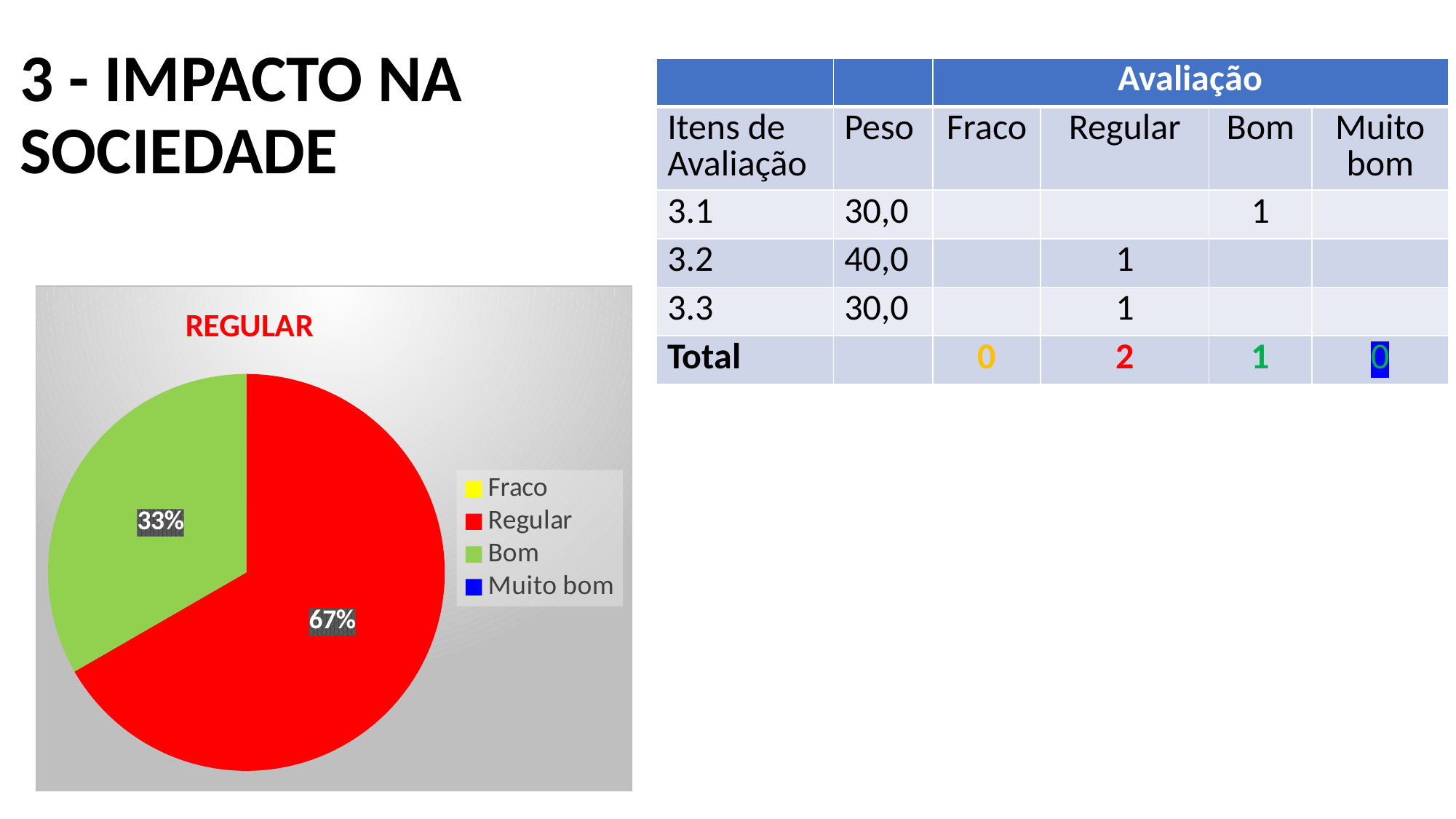
Which is larger in the pie chart, the Regular slice or the Bom slice? Regular Which legend entries have no visible slice in the pie chart? Fraco and Muito bom What share of the pie does the Regular slice represent? 67% How many entries does the pie chart's legend list? 4 Is the share for Regular greater or less than 50%? greater Which category has the largest slice in the pie chart? Regular How many slices are visible in the pie chart? 2 What share of the pie does the Bom slice represent? 33% What kind of chart is shown on the slide? pie chart What colour is the Regular slice in the pie chart? red What is the title of the pie chart? REGULAR What is the difference in percentage points between the Regular slice and the Bom slice? 34%